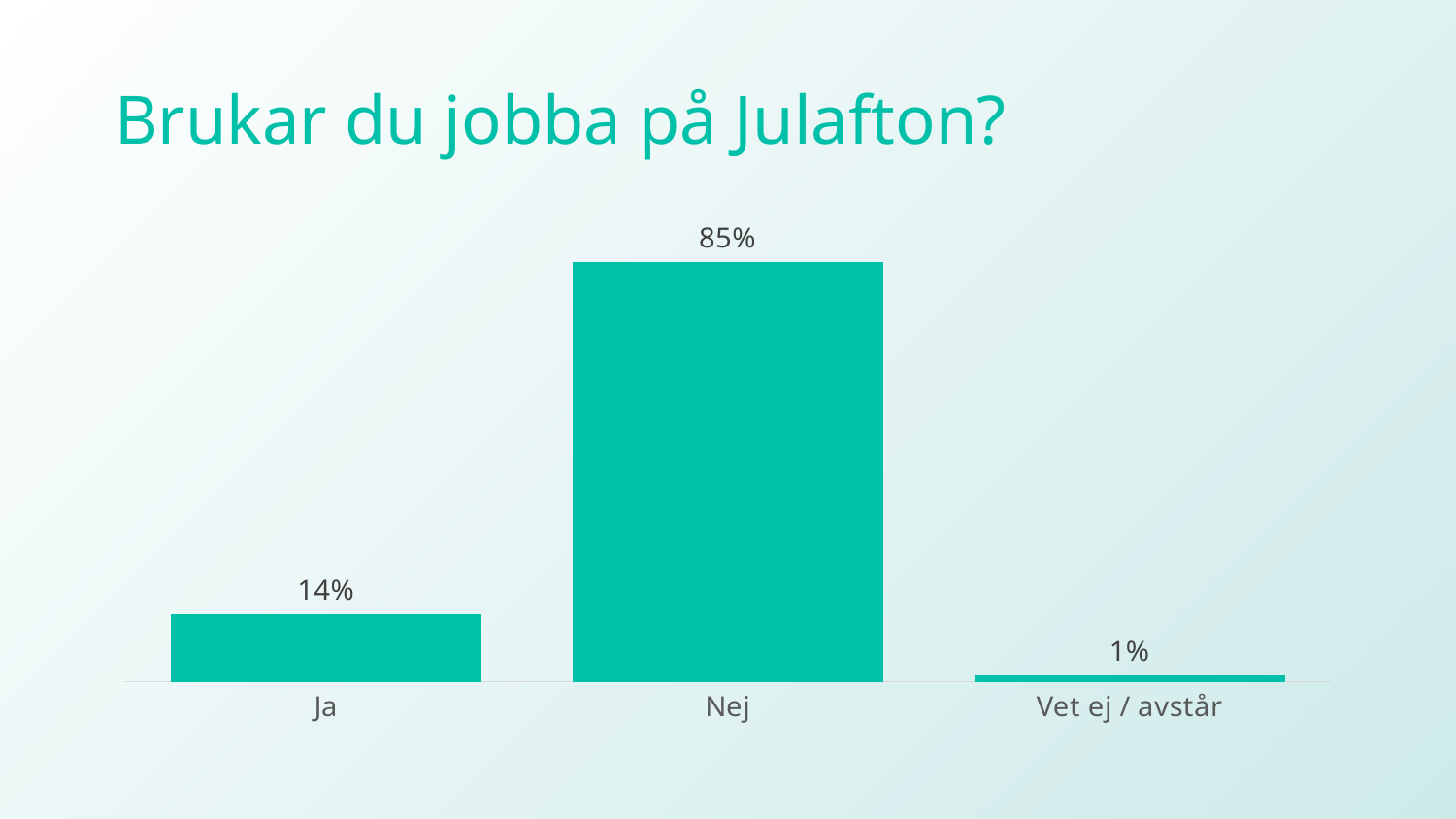
Which category has the lowest value? Vet ej / avstår Which is larger, the value for Ja or the value for Vet ej / avstår? Ja Which is larger, the value for Ja or the value for Nej? Nej What is the difference between the values for Nej and Ja? 71% What is the value for Nej? 85% Which category has the highest value? Nej What is the title of the chart? Brukar du jobba på Julafton? What is the value for Ja? 14% What kind of chart is shown on the slide? Bar chart What is the difference between the values for Ja and Vet ej / avstår? 13% How many categories are shown in the chart? 3 What is the value for Vet ej / avstår? 1%